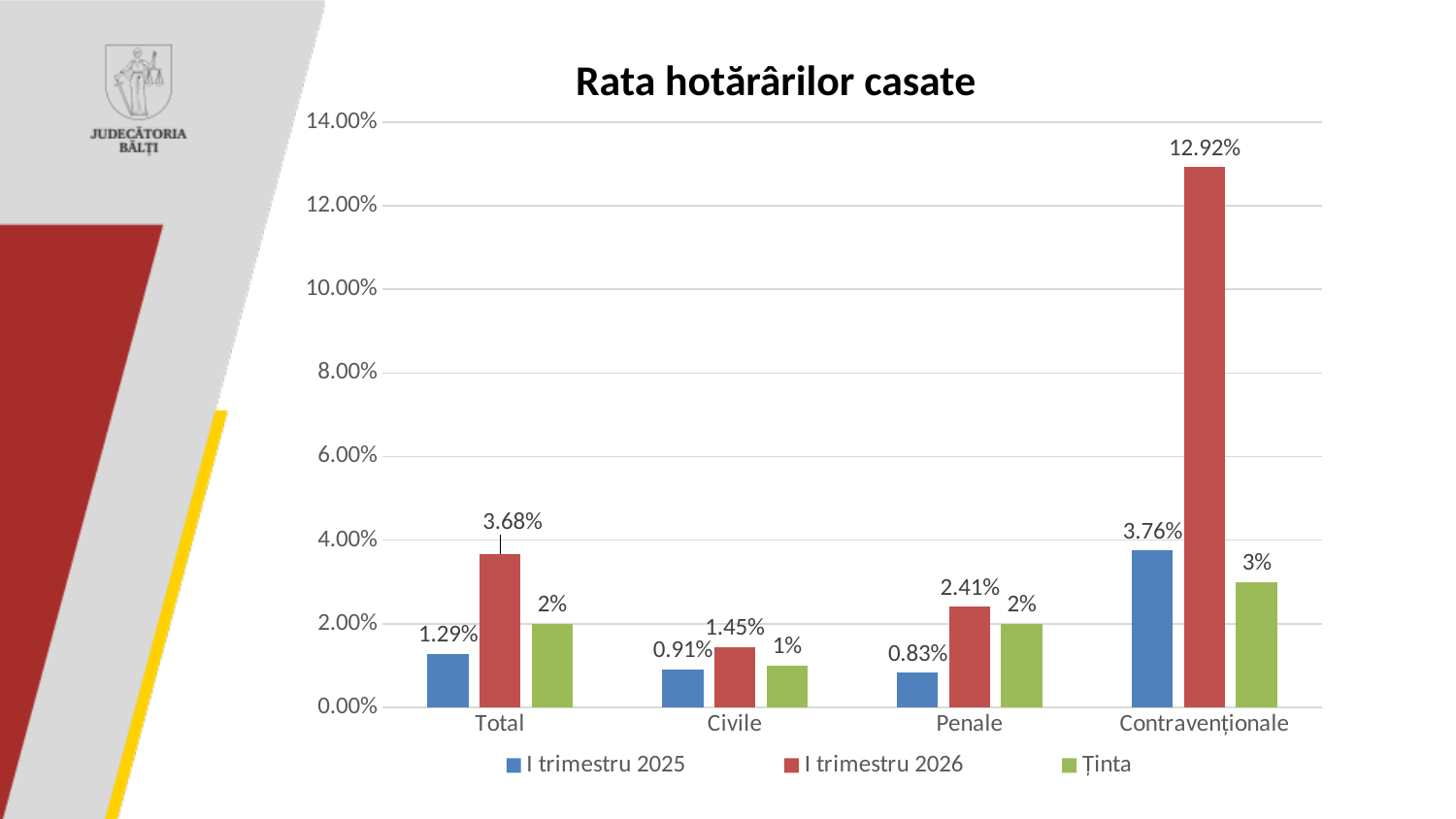
What is the value for I trimestru 2026 in the Contravenționale category? 12.92% How many series does the legend list? 3 What is the value for I trimestru 2025 in the Total category? 1.29% What is the difference between the I trimestru 2026 and I trimestru 2025 values for Total? 2.39% Which category has the highest value for I trimestru 2026? Contravenționale Which category has the lowest value for I trimestru 2025? Penale How many categories are shown on the x axis? 4 What is the Ținta value for the Penale category? 2% What kind of chart is shown on the slide? Bar chart Which is larger for Penale: the I trimestru 2026 value or the Ținta value? I trimestru 2026 What is the title of the chart? Rata hotărârilor casate What is the value for I trimestru 2025 in the Civile category? 0.91%